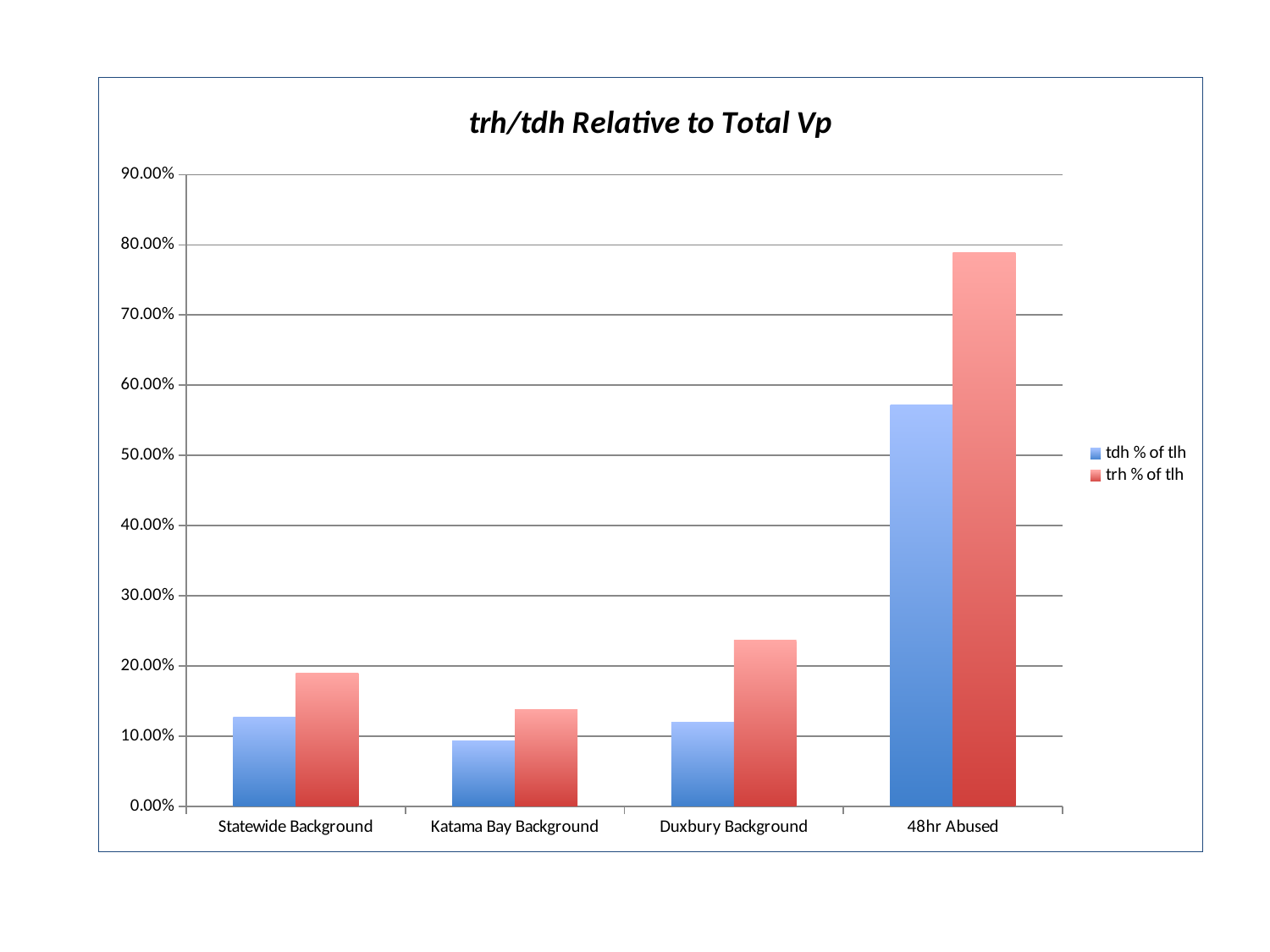
Which category has the highest value for trh % of tlh? 48hr Abused Which category has the lowest value for trh % of tlh? Katama Bay Background Which category has the lowest value for tdh % of tlh? Katama Bay Background What is the title of the chart? trh/tdh Relative to Total Vp Which is larger for Duxbury Background: tdh % of tlh or trh % of tlh? trh % of tlh Which has the larger trh % of tlh value: Statewide Background or Duxbury Background? Duxbury Background Is the tdh % of tlh value for 48hr Abused greater or less than 50%? greater How many categories are shown on the x axis? 4 What kind of chart is shown on the slide? bar chart Is the tdh % of tlh value for Katama Bay Background greater or less than 10%? less Is the trh % of tlh value for 48hr Abused greater or less than 70%? greater How many series does the legend list? 2